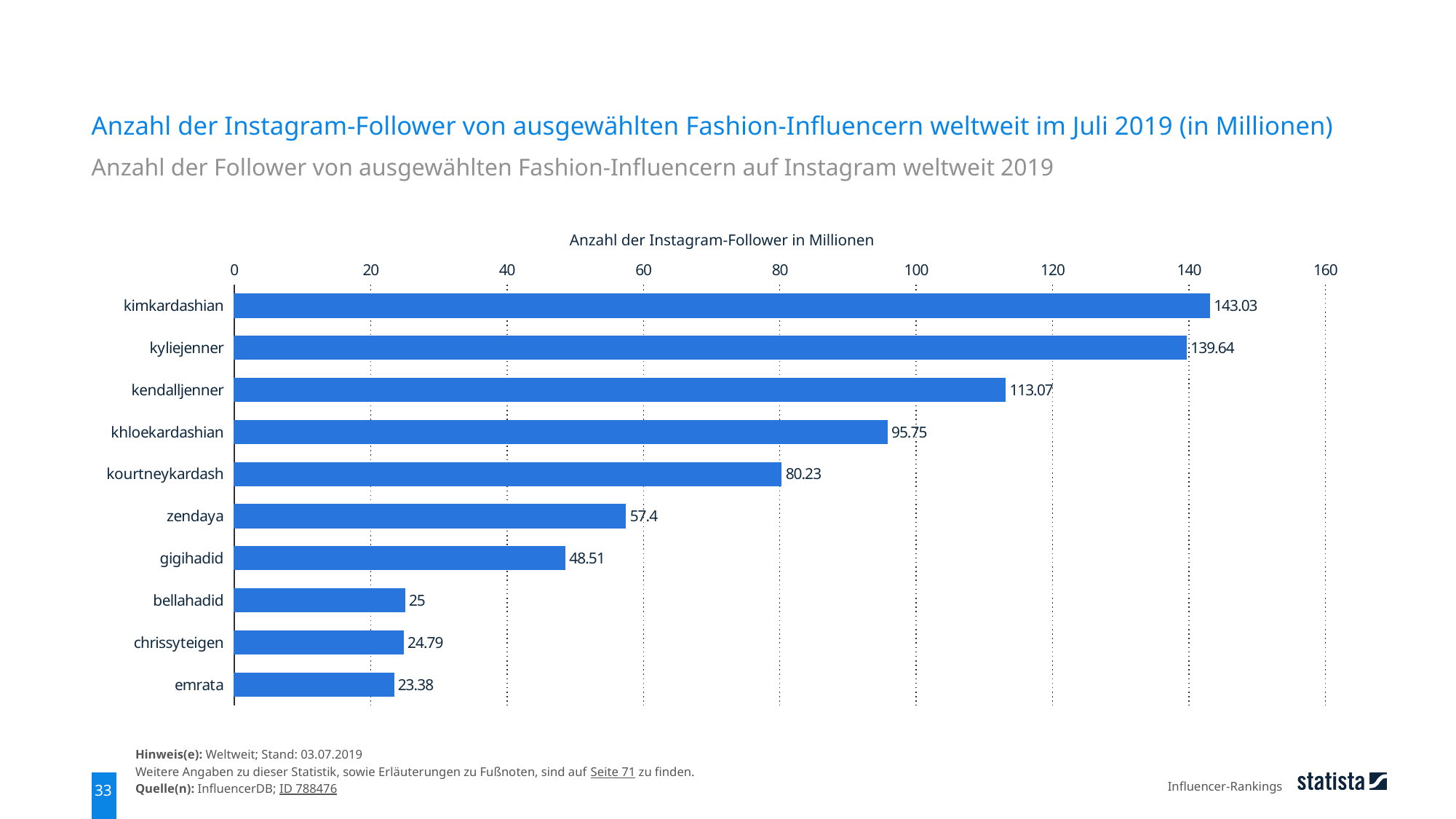
Is the value for kourtneykardash greater or less than 100? less What is the difference between the values for kimkardashian and kyliejenner? 3.39 What is the axis title shown above the chart? Anzahl der Instagram-Follower in Millionen What is the value shown for zendaya? 57.4 What is the value shown for chrissyteigen? 24.79 What kind of chart is shown on the slide? bar chart Which influencer has the highest number of Instagram followers on the chart? kimkardashian How many Instagram followers (in millions) does kimkardashian have according to the chart? 143.03 Which influencer has the lowest number of Instagram followers on the chart? emrata How many influencers are shown on the chart? 10 Which has a larger value, gigihadid or bellahadid? gigihadid What is the difference between the values for kendalljenner and khloekardashian? 17.32